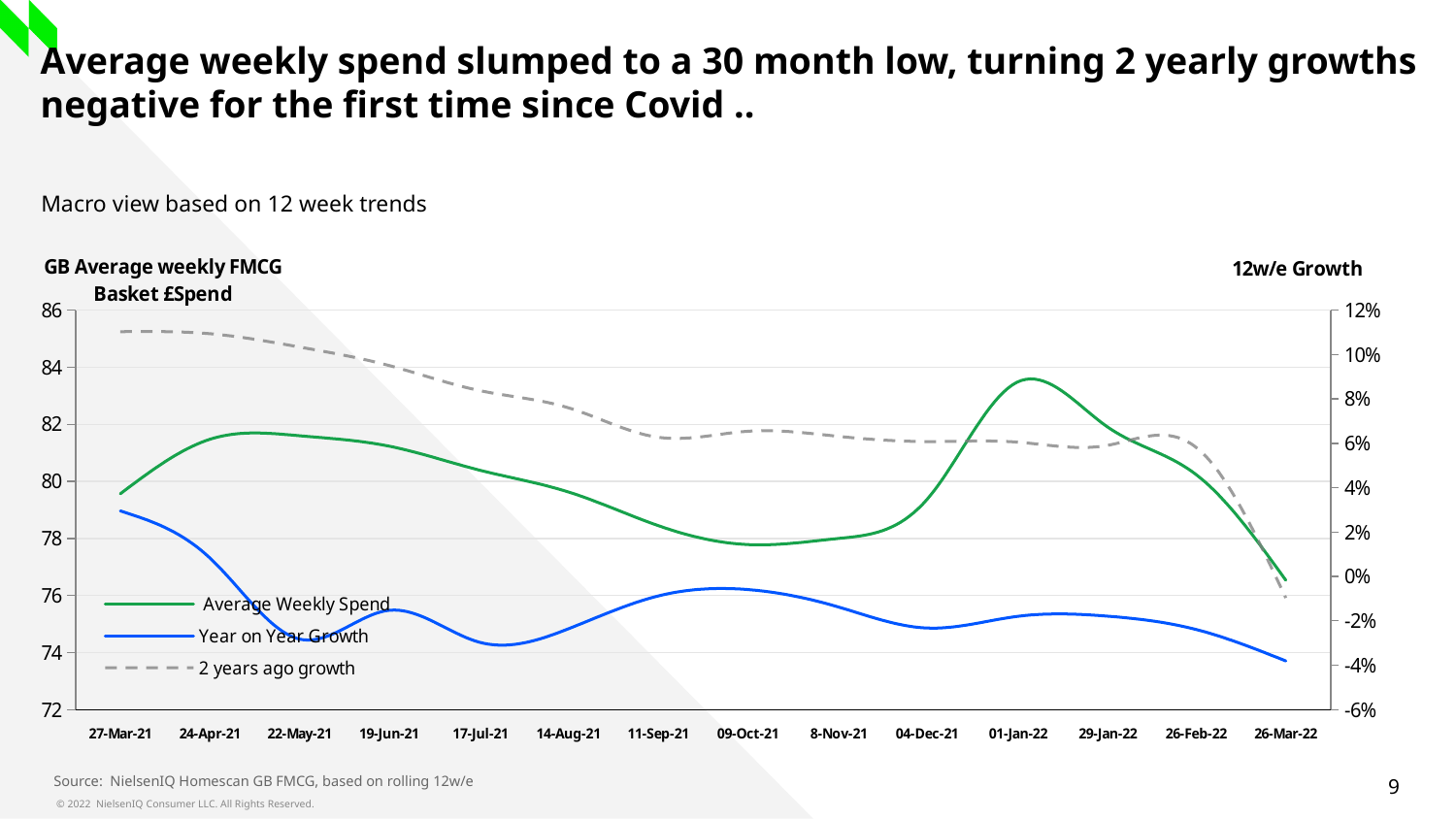
How many series does the chart's legend list? 3 How many date labels are shown along the x axis of the chart? 14 Is the value for Year on Year Growth at 22-May-21 greater or less than 0%? less Is the value for 2 years ago growth at 27-Mar-21 greater or less than 10%? greater Does the 2 years ago growth line rise or fall overall from 27-Mar-21 to 26-Mar-22? fall What is the title shown above the right-hand axis of the chart? 12w/e Growth At 27-Mar-21, which is larger: Year on Year Growth or 2 years ago growth? 2 years ago growth At which x-axis date label is Average Weekly Spend at its lowest? 26-Mar-22 What kind of chart is shown on the slide? line chart Is the value for Average Weekly Spend at 01-Jan-22 greater or less than 82? greater